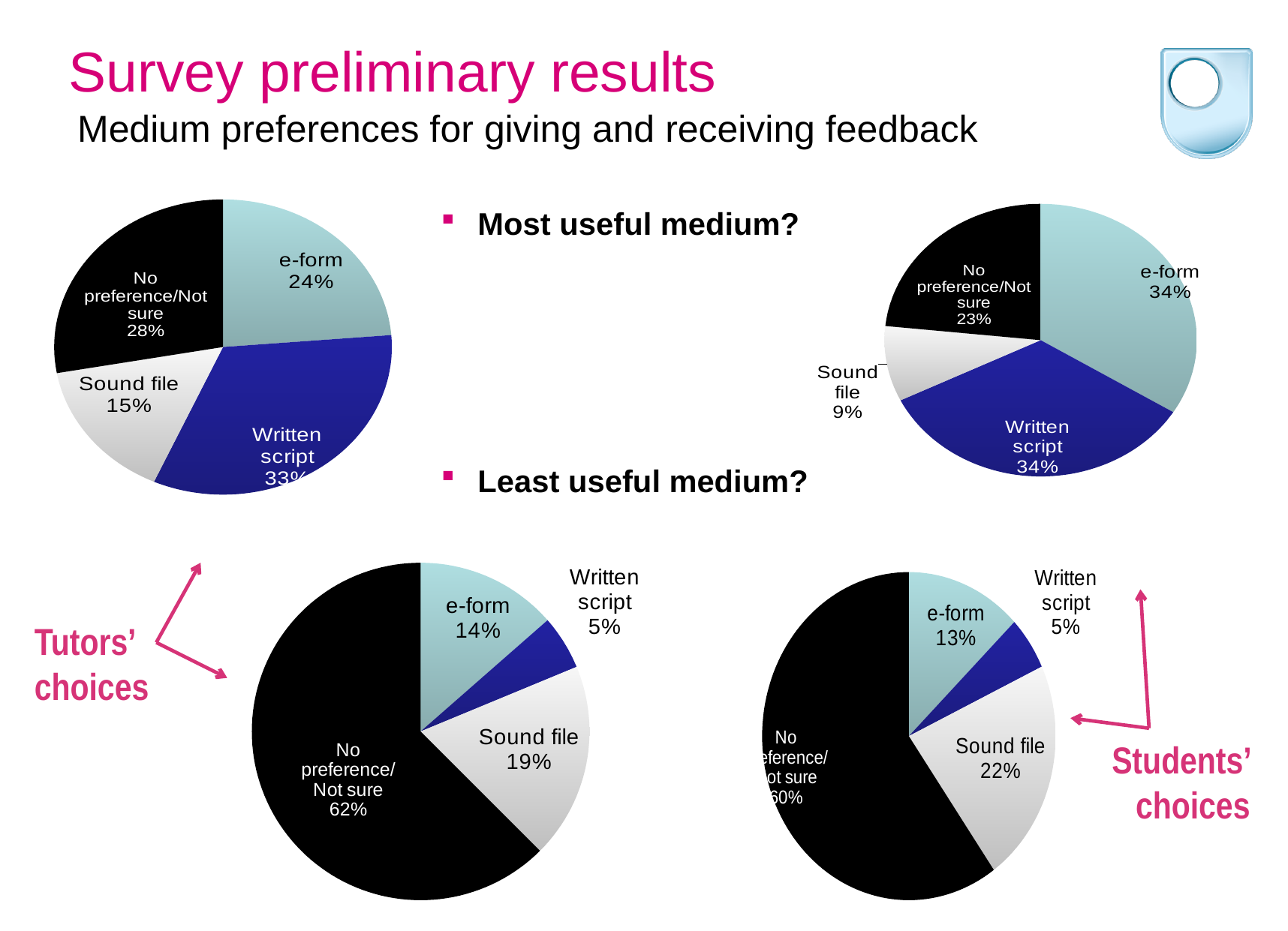
In the bottom-right pie chart (students' least useful medium), what is the difference between the Sound file share and the e-form share? 9% How many slices does the top-right pie chart (students' most useful medium) have? 4 In the top-left pie chart (tutors' most useful medium), what percentage chose Written script? 33% In the top-left pie chart (tutors' most useful medium), what percentage chose Sound file? 15% In the top-right pie chart (students' most useful medium), which category has the smallest share? Sound file In the bottom-left pie chart (tutors' least useful medium), what percentage chose Sound file? 19% What type of chart is used in the bottom-left chart (tutors' least useful medium)? Pie chart In the top-left pie chart (tutors' most useful medium), what is the combined share of e-form and Written script? 57% In the top-right pie chart (students' most useful medium), what percentage chose e-form? 34% In the bottom-right pie chart (students' least useful medium), what percentage chose Written script? 5% In the top-left pie chart (tutors' most useful medium), which is larger: the share for e-form or the share for No preference/Not sure? No preference/Not sure In the bottom-left pie chart (tutors' least useful medium), which category has the largest share? No preference/Not sure